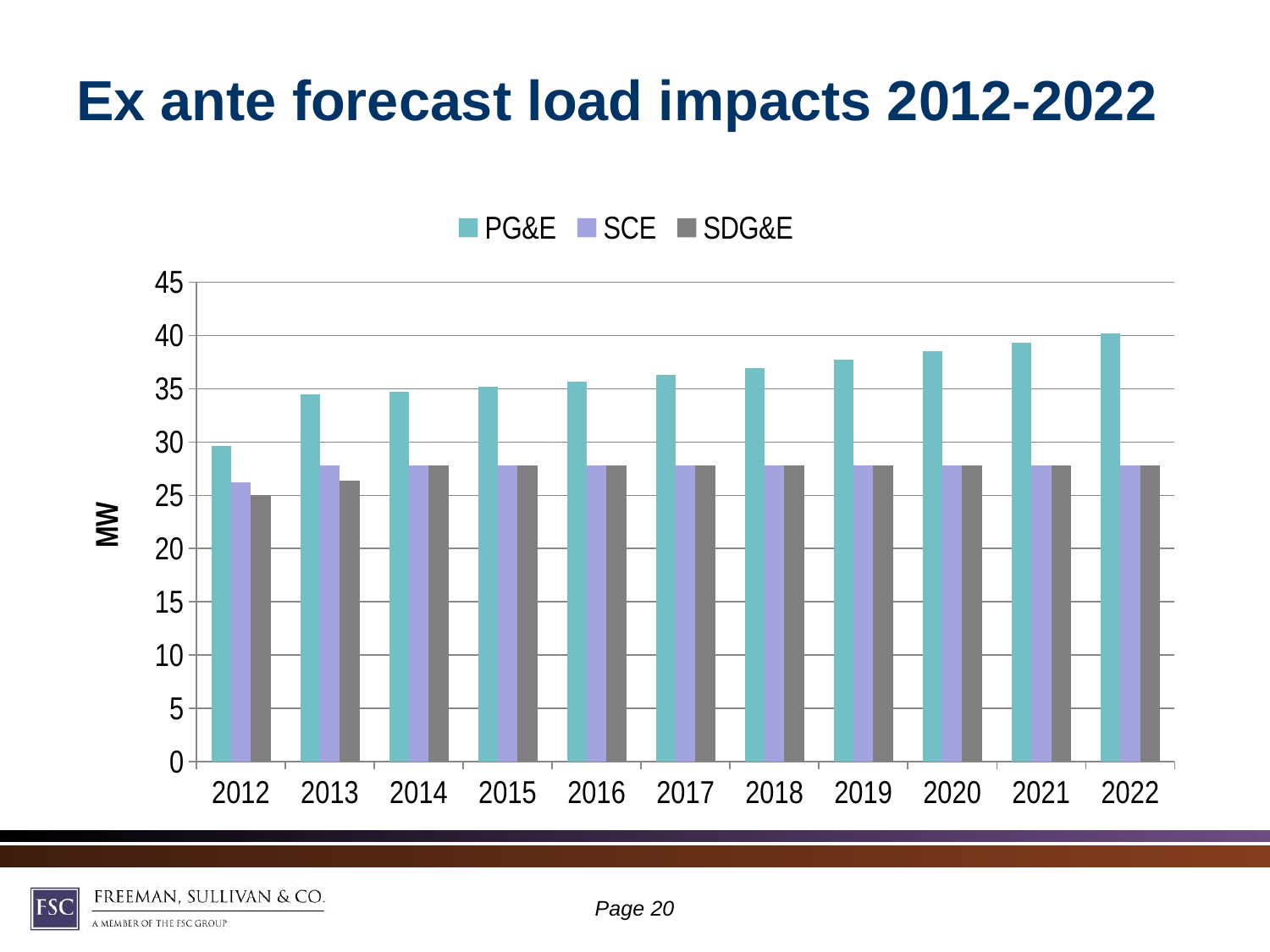
Is the SCE value for 2015 greater or less than 30? less Is the SDG&E value for 2012 greater or less than 30? less How many series does the legend list? 3 In 2016, which is larger, the PG&E value or the SCE value? PG&E Which year has the lowest SDG&E value? 2012 How many years are shown on the x axis? 11 Do the PG&E values rise or fall from 2012 to 2022? rise What kind of chart is shown on the slide? bar chart Which year has the highest PG&E value? 2022 Which year has the lowest PG&E value? 2012 What is the label on the y axis? MW Is the PG&E value for 2022 greater or less than 35? greater